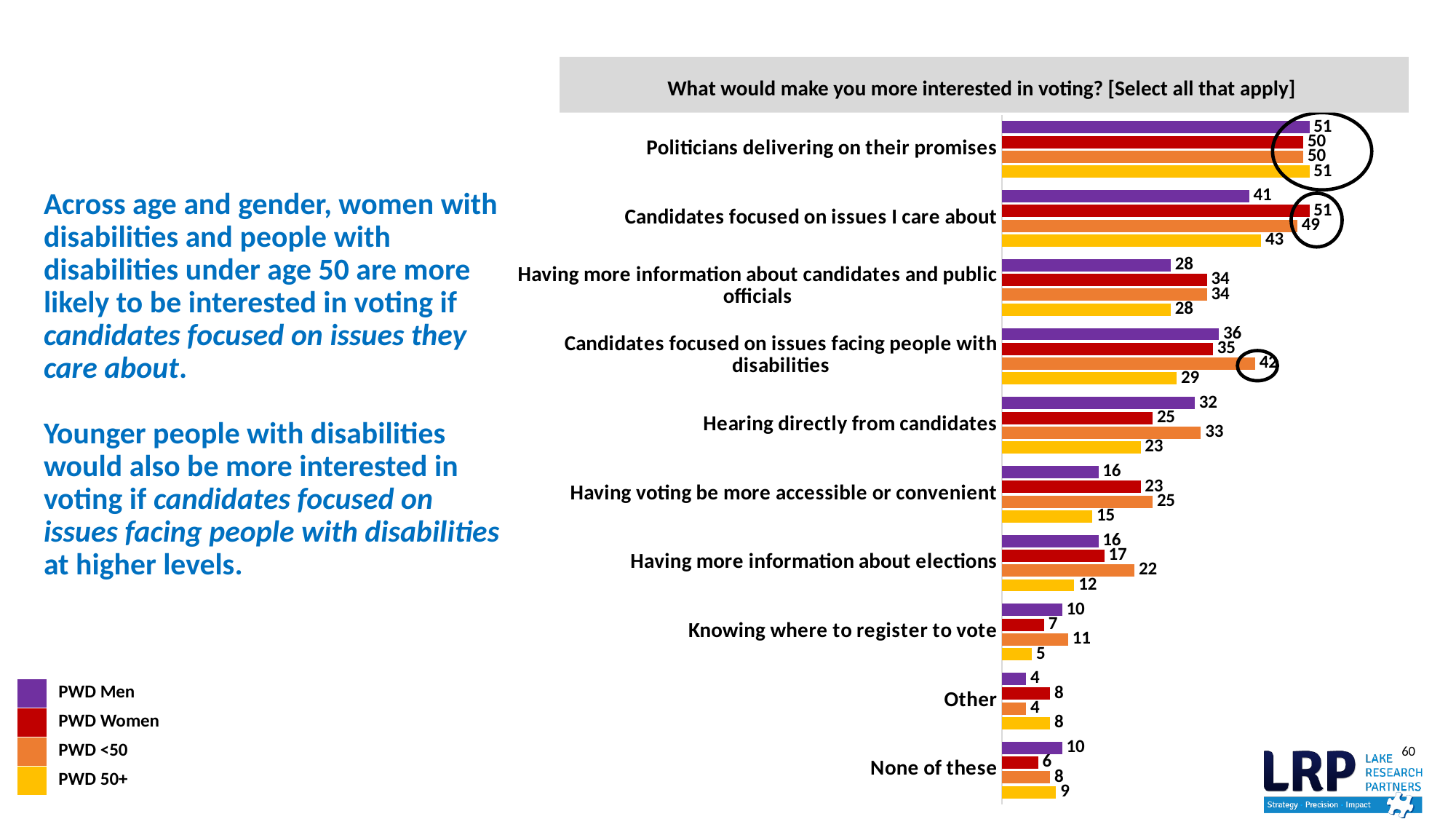
What kind of chart is shown on the slide? Bar chart What is the value for PWD Women for "Candidates focused on issues I care about"? 51 What is the value for PWD <50 for "Candidates focused on issues facing people with disabilities"? 42 What is the title of the chart? What would make you more interested in voting? [Select all that apply] Which category has the lowest value for PWD 50+? Knowing where to register to vote Which category has the highest value for PWD Men? Politicians delivering on their promises For "Having voting be more accessible or convenient", which is larger: the PWD Women value or the PWD Men value? PWD Women What is the difference between the PWD <50 and PWD 50+ values for "Candidates focused on issues facing people with disabilities"? 13 What is the value for PWD Men for "Hearing directly from candidates"? 32 How many series does the legend list? 4 What is the value for PWD 50+ for "Having more information about elections"? 12 How many categories are shown on the chart? 10